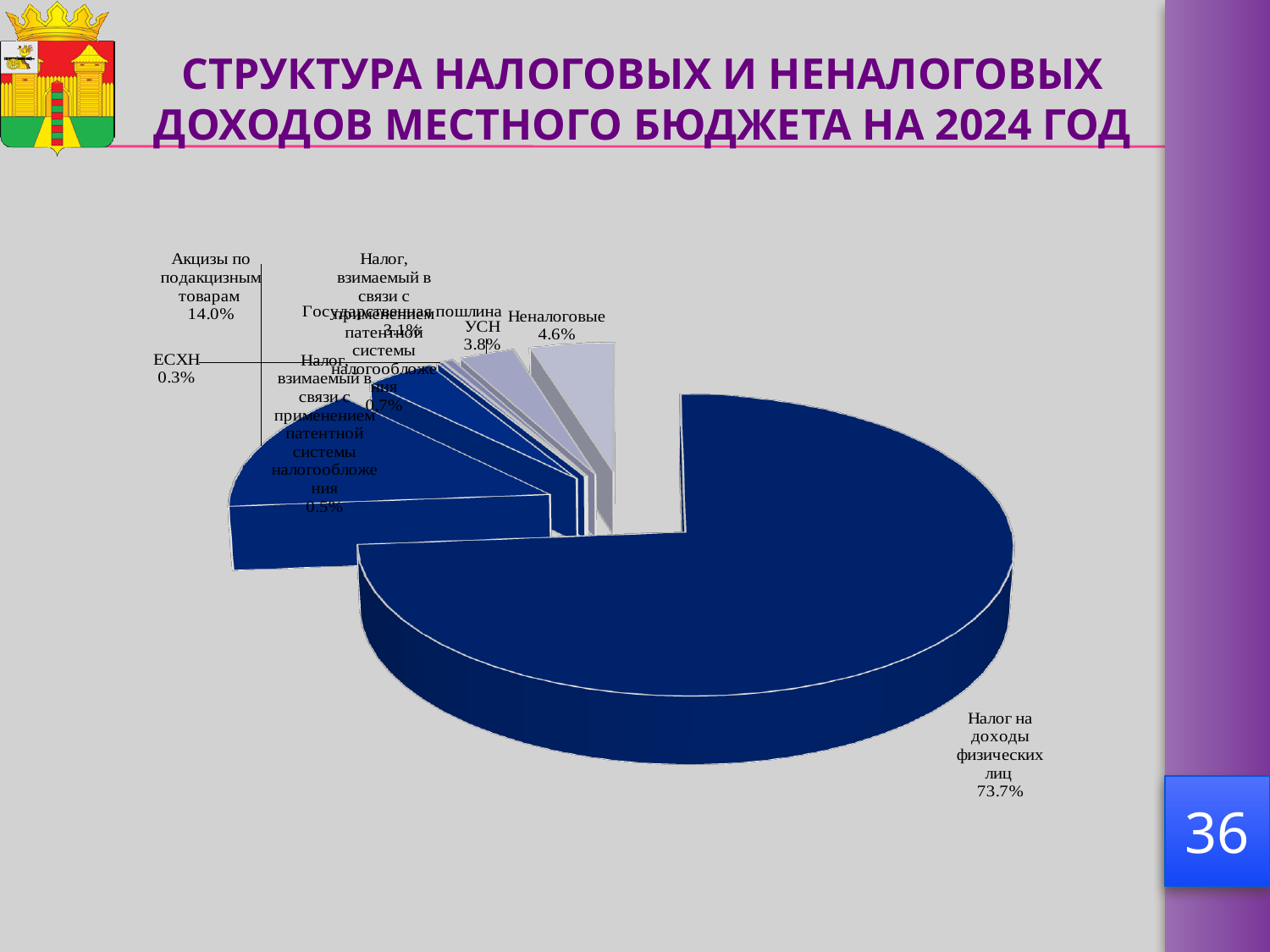
What year does the slide title say the budget revenue structure refers to? 2024 What share is shown for "УСН"? 3.8% Which labelled category has the smallest share? ЕСХН By how many percentage points does "Налог на доходы физических лиц" exceed "Акцизы по подакцизным товарам"? 59.7 What kind of chart is shown on the slide? pie chart What share is shown for "Акцизы по подакцизным товарам"? 14.0% What is the difference between the shares of "Неналоговые" and "УСН"? 0.8 What share of the pie is labelled for "Налог на доходы физических лиц"? 73.7% Which category has the largest slice of the pie? Налог на доходы физических лиц What share is shown for "Неналоговые"? 4.6% Which is larger, the share for "УСН" or for "Неналоговые"? Неналоговые What share is shown for "ЕСХН"? 0.3%